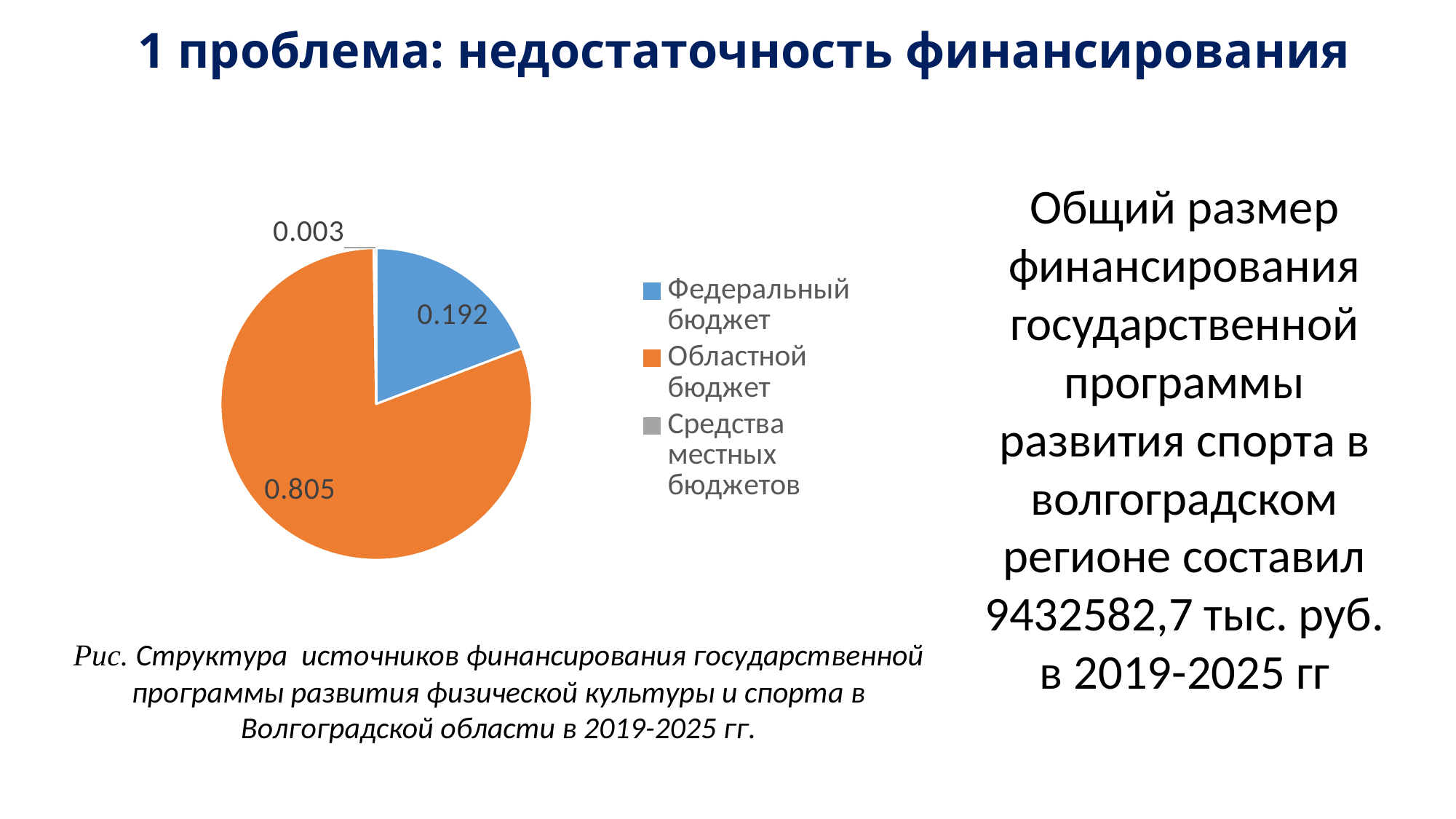
What colour is the slice for Областной бюджет in the pie chart? orange What is the difference between the values for Федеральный бюджет and Средства местных бюджетов? 0.189 Which source of funding has the smallest slice in the pie chart? Средства местных бюджетов How many entries does the legend of the pie chart list? 3 How many slices does the pie chart have? 3 Which source of funding has the largest slice in the pie chart? Областной бюджет What is the difference between the values for Областной бюджет and Федеральный бюджет? 0.613 What is the value for Федеральный бюджет in the pie chart? 0.192 What is the value for Средства местных бюджетов in the pie chart? 0.003 What is the value for Областной бюджет in the pie chart? 0.805 What kind of chart is shown on the slide? pie chart Which is larger: the value for Федеральный бюджет or the value for Областной бюджет? Областной бюджет